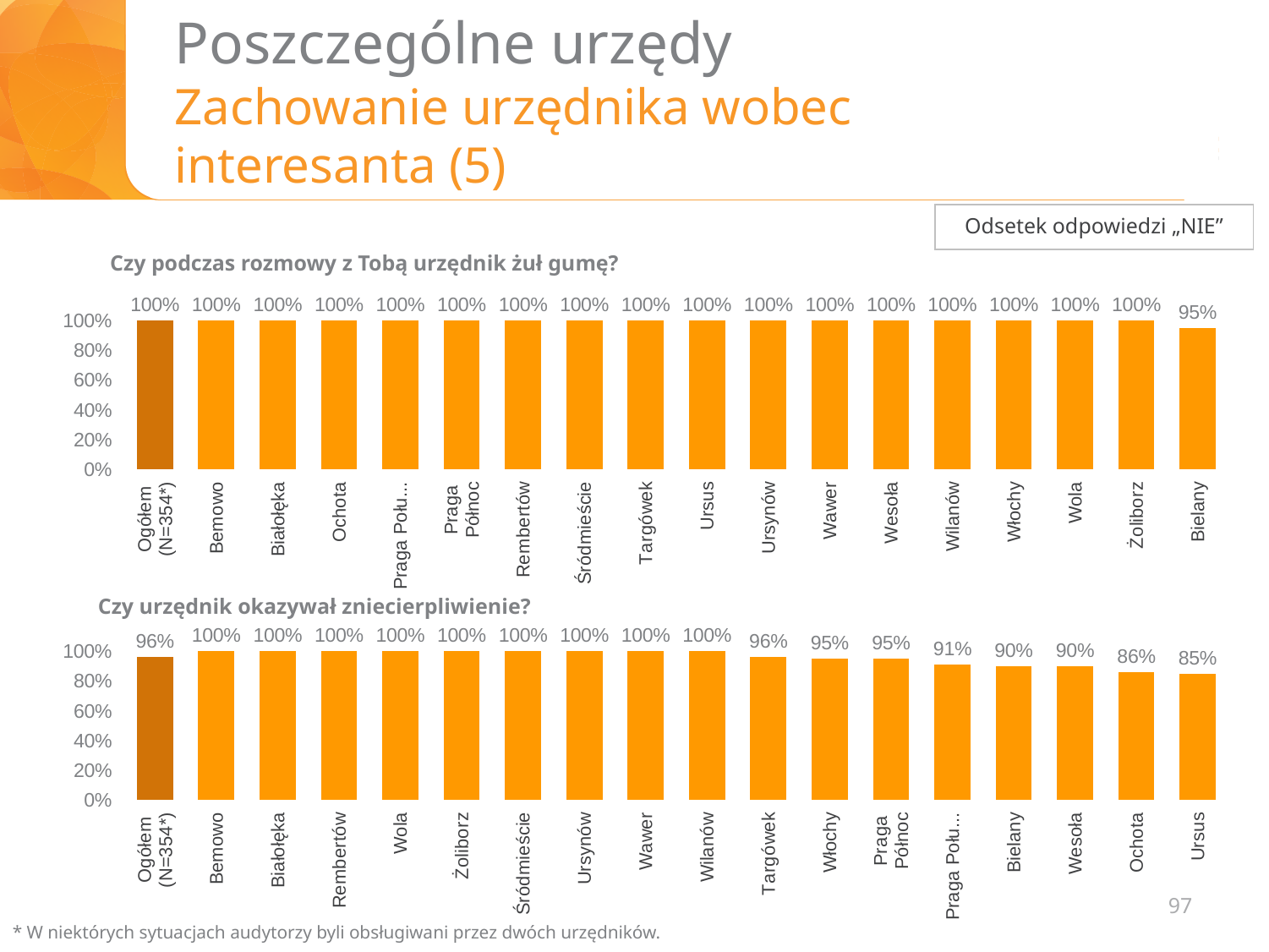
In the bottom chart ("Czy urzędnik okazywał zniecierpliwienie?"), what is the value for Wesoła? 90% In the bottom chart ("Czy urzędnik okazywał zniecierpliwienie?"), which category has the lowest value? Ursus In the top chart ("Czy podczas rozmowy z Tobą urzędnik żuł gumę?"), what is the value for Bielany? 95% In the bottom chart ("Czy urzędnik okazywał zniecierpliwienie?"), what is the value for Ogółem (N=354*)? 96% In the bottom chart ("Czy urzędnik okazywał zniecierpliwienie?"), which is larger, the value for Włochy or the value for Bielany? Włochy What kind of chart is the top chart ("Czy podczas rozmowy z Tobą urzędnik żuł gumę?")? Bar chart In the bottom chart ("Czy urzędnik okazywał zniecierpliwienie?"), what is the value for Ursus? 85% In the top chart ("Czy podczas rozmowy z Tobą urzędnik żuł gumę?"), what is the value for Ogółem (N=354*)? 100% In the bottom chart ("Czy urzędnik okazywał zniecierpliwienie?"), do the values rise or fall from Targówek to Ursus along the x axis? Fall How many categories are shown in the bottom chart ("Czy urzędnik okazywał zniecierpliwienie?")? 18 In the top chart ("Czy podczas rozmowy z Tobą urzędnik żuł gumę?"), which category has the lowest value? Bielany In the bottom chart ("Czy urzędnik okazywał zniecierpliwienie?"), what is the difference between the values for Bemowo and Ochota? 14%